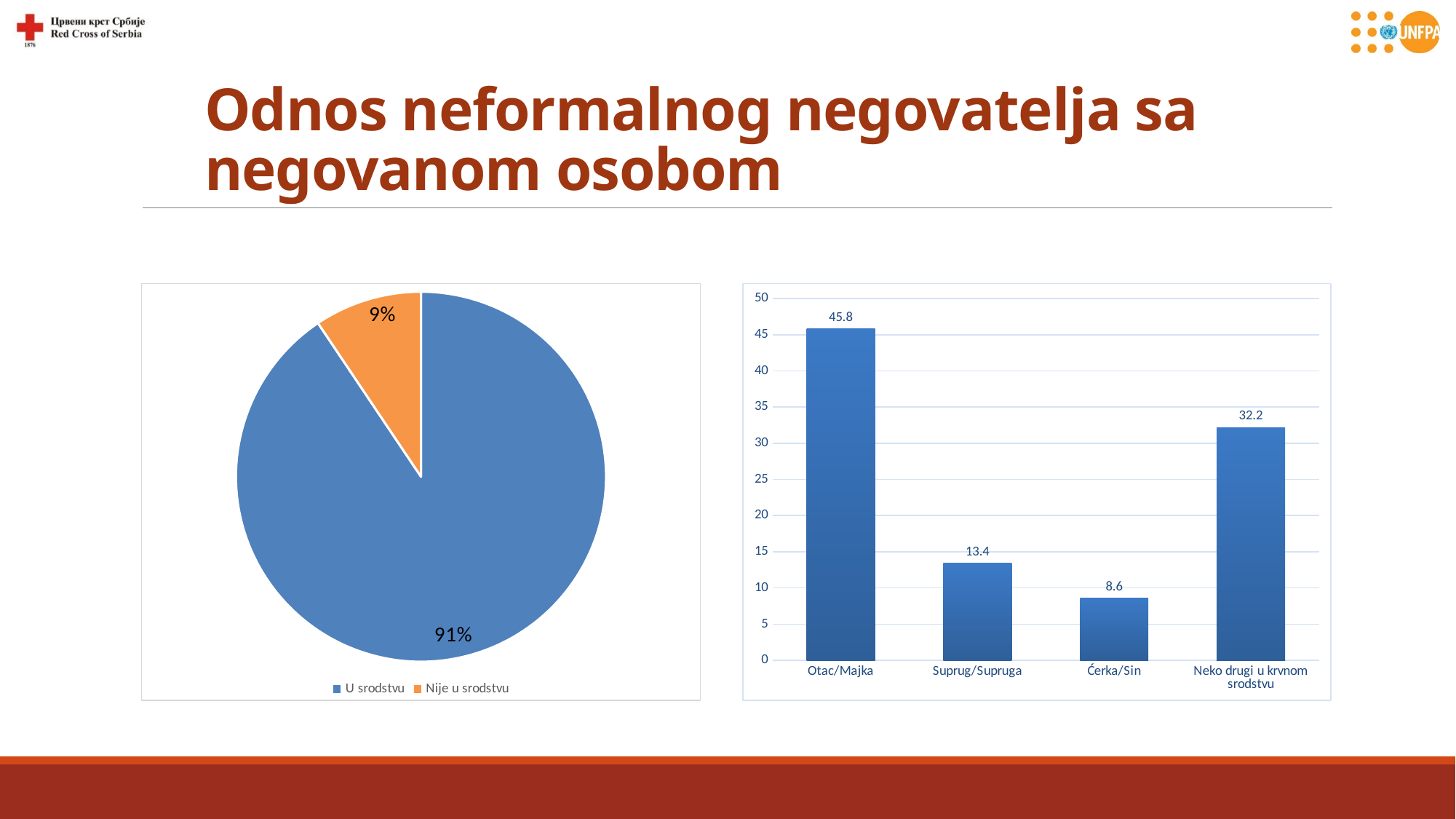
In the pie chart on the left, what share is labelled for 'Nije u srodstvu'? 9% In the bar chart on the right, what is the value for Otac/Majka? 45.8 In the bar chart on the right, which is larger: Suprug/Supruga or Neko drugi u krvnom srodstvu? Neko drugi u krvnom srodstvu In the bar chart on the right, what is the value for Ćerka/Sin? 8.6 In the pie chart on the left, which slice is the largest? U srodstvu In the bar chart on the right, which category has the highest value? Otac/Majka In the bar chart on the right, which category has the lowest value? Ćerka/Sin In the pie chart on the left, what share is labelled for 'U srodstvu'? 91% In the bar chart on the right, what is the difference between the values for Otac/Majka and Neko drugi u krvnom srodstvu? 13.6 What kind of chart is shown on the right side of the slide? Bar chart In the pie chart on the left, what colour is the 'Nije u srodstvu' slice? Orange In the pie chart on the left, how many slices does the pie have? 2